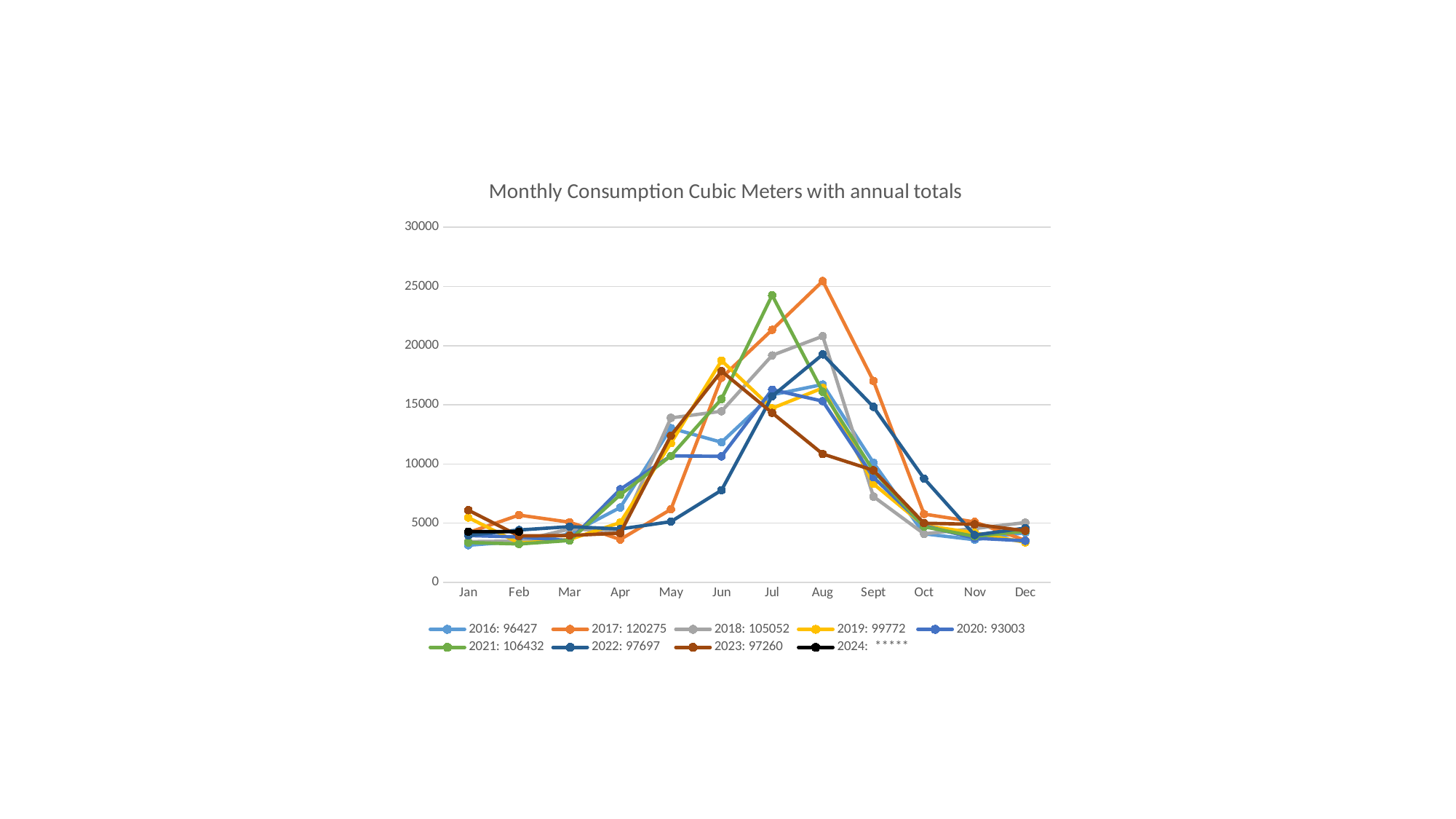
In which month does the 2021 line reach its highest value? Jul What annual total does the legend show for 2017? 120275 Which annual total is larger, 2018 or 2021? 2021 What is the title of the chart? Monthly Consumption Cubic Meters with annual totals What annual total does the legend show for 2020? 93003 How many months are shown along the x axis? 12 What kind of chart is shown on the slide? line chart Which year has the lowest annual total in the legend? 2020 Which year has the highest annual total in the legend? 2017 What is the difference between the annual totals for 2017 and 2016 shown in the legend? 23848 How many series does the legend list? 9 Is the value for 2017 in Aug greater or less than 20000? greater